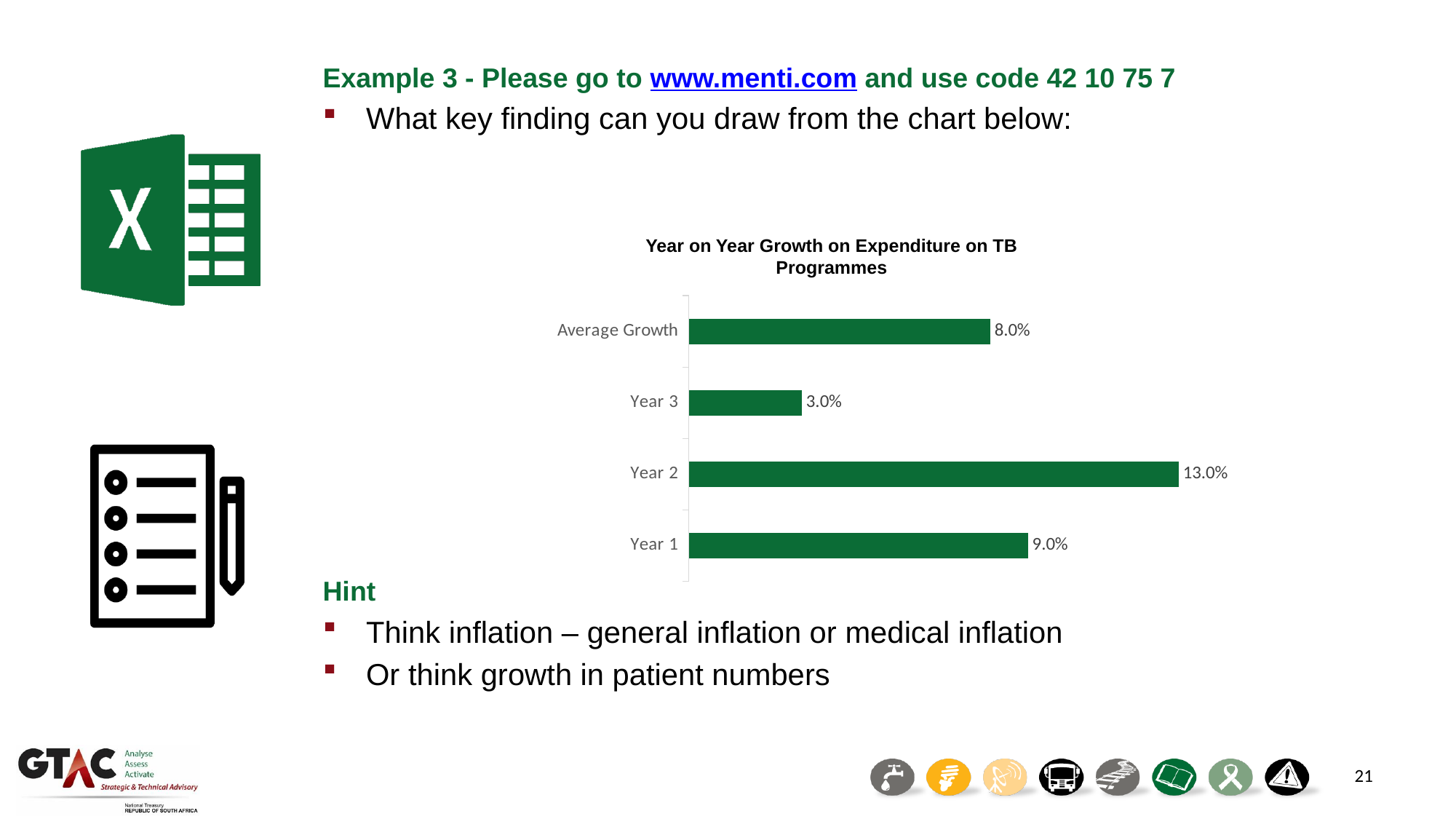
What is the value for Year 3? 3.0% What is the value for Year 1? 9.0% What is the value for Year 2? 13.0% Which category has the lowest value? Year 3 How many categories are shown in the chart? 4 Which is larger, the value for Year 1 or the value for Year 3? Year 1 What is the title of the chart? Year on Year Growth on Expenditure on TB Programmes What is the difference between the values for Year 1 and Average Growth? 1.0% What is the difference between the values for Year 2 and Year 3? 10.0% Which category has the highest value? Year 2 What kind of chart is shown on the slide? Bar chart What is the value for Average Growth? 8.0%